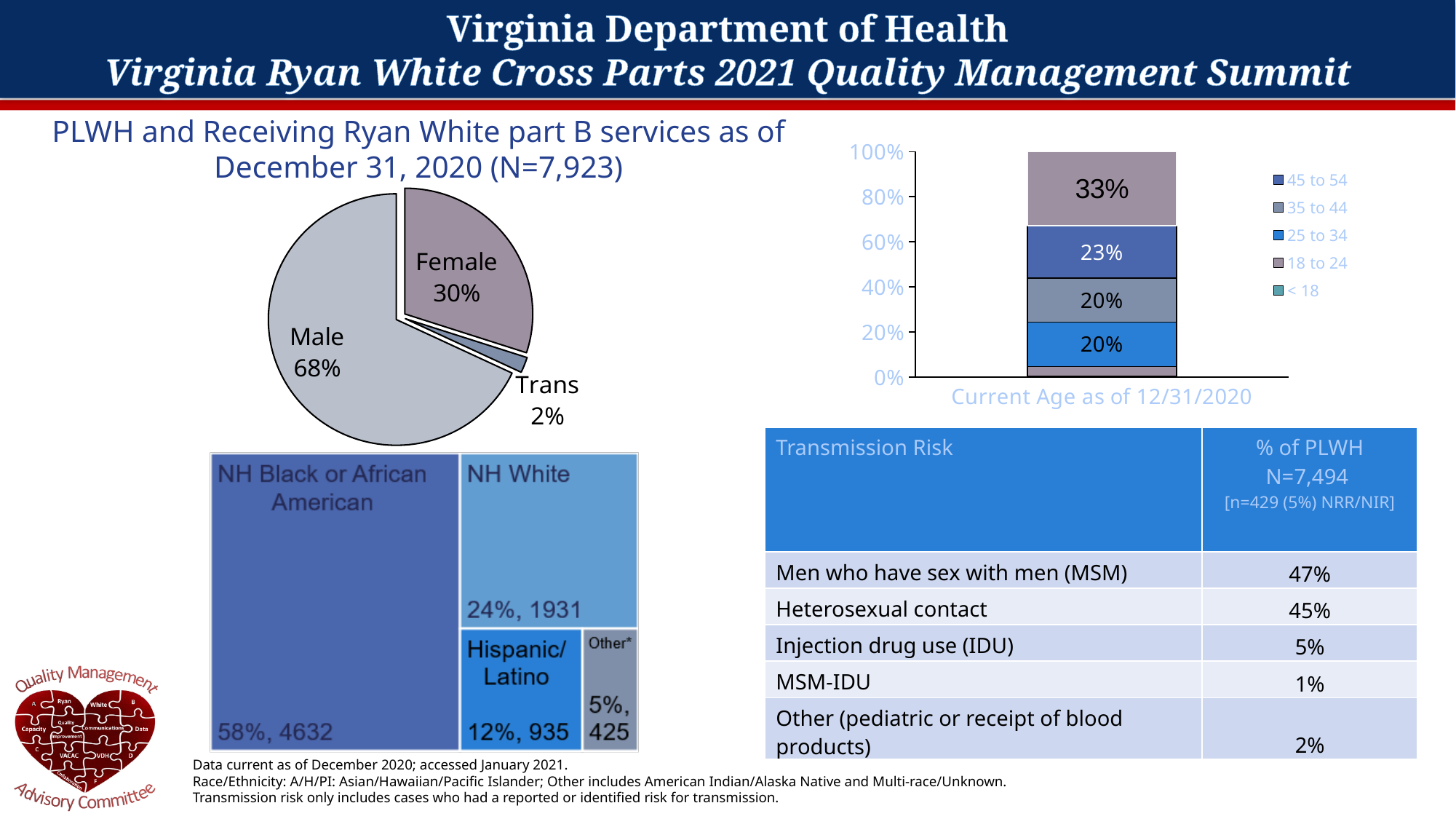
How many entries does the legend of the stacked bar chart 'Current Age as of 12/31/2020' list? 5 In the pie chart, what percentage is Male? 68% In the pie chart, what percentage is Female? 30% In the race/ethnicity treemap, how many people are NH Black or African American? 4632 In the pie chart, how many percentage points larger is Male than Female? 38 percentage points In the race/ethnicity treemap, what percentage is NH White? 24% In the race/ethnicity treemap, how many more people are NH White than Hispanic/Latino? 996 How many slices does the pie chart have? 3 In the stacked bar chart 'Current Age as of 12/31/2020', what is the value of the second segment from the top? 23% In the stacked bar chart titled 'Current Age as of 12/31/2020', what is the value of the largest labelled segment? 33% In the pie chart, which category has the smallest slice? Trans What kind of chart shows the breakdown by Male, Female and Trans? Pie chart